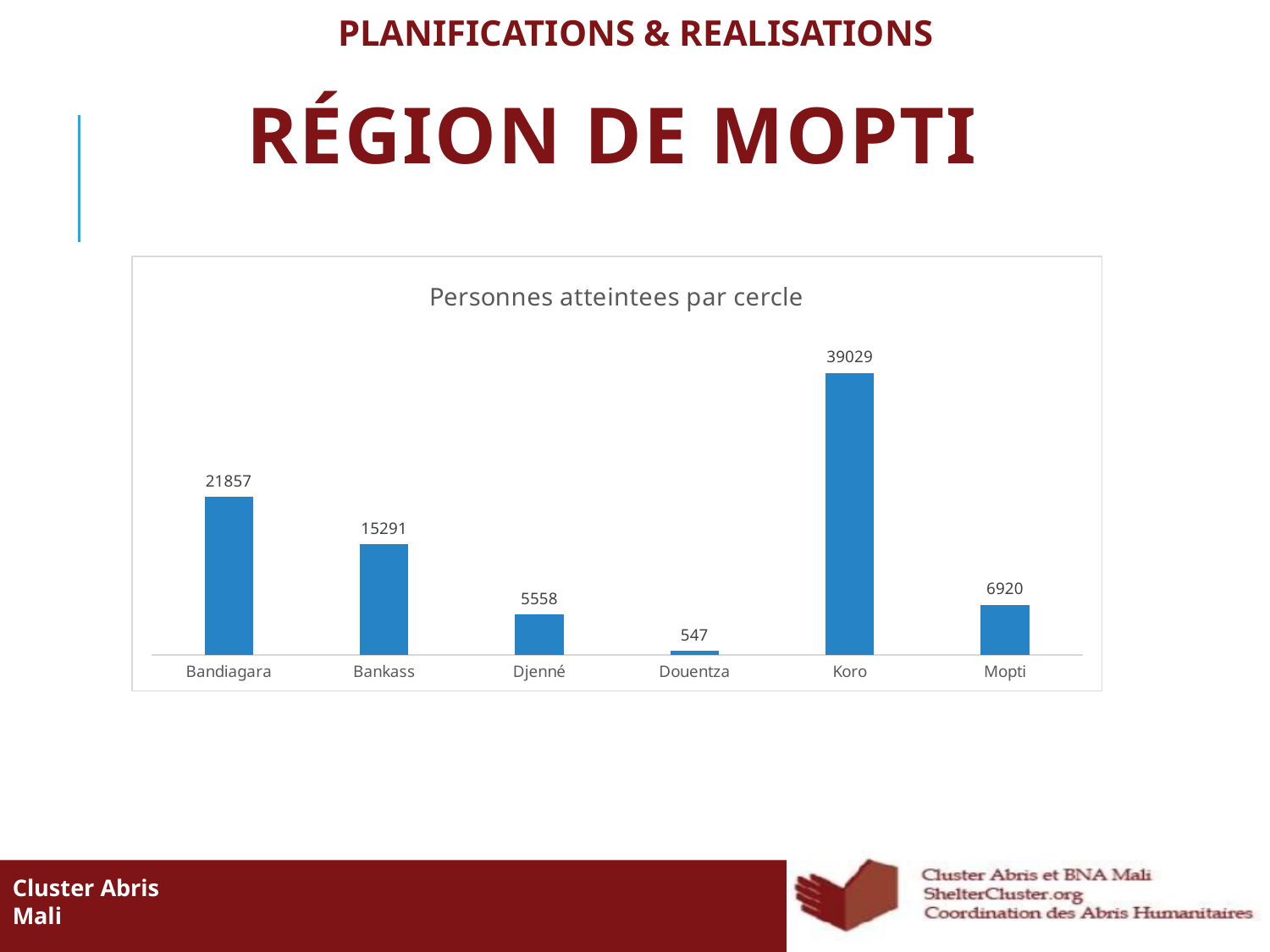
What is the difference between the values for Bankass and Djenné? 9733 Which cercle has the lowest value in the chart? Douentza What is the difference between the values for Koro and Bandiagara? 17172 How many cercles are shown on the x axis of the chart? 6 Which is larger, the value for Mopti or the value for Djenné? Mopti What is the value for Mopti in the chart? 6920 What is the value for Koro in the chart? 39029 Which cercle has the highest value in the chart? Koro What is the value for Douentza in the chart? 547 What kind of chart is shown on the slide? Bar chart What is the value for Bandiagara in the chart? 21857 What is the title of the chart? Personnes atteintees par cercle